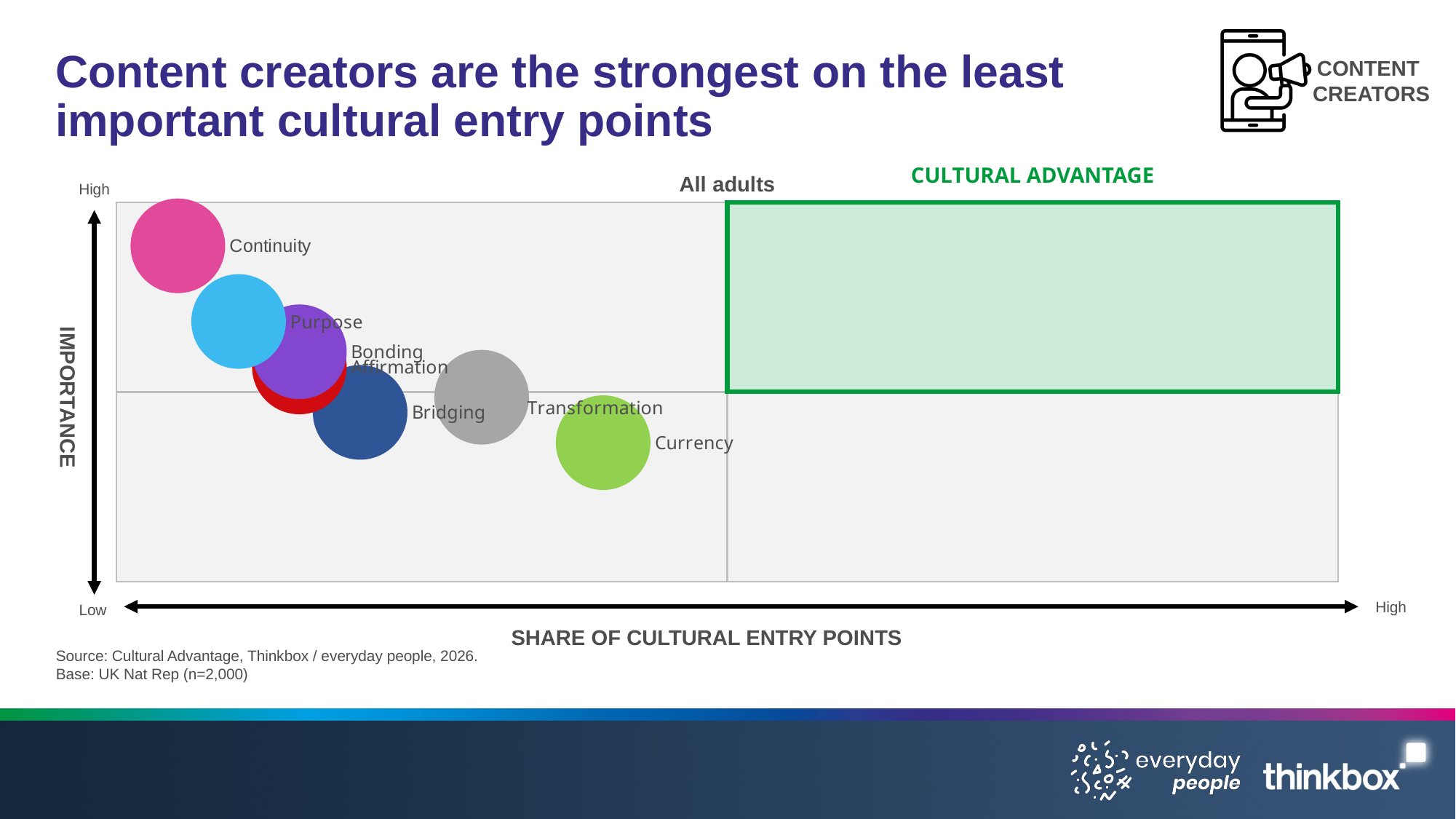
Which cultural entry point has the highest importance on the chart? Continuity Which cultural entry point has the highest share of cultural entry points for content creators? Currency Which cultural entry point has the lowest importance on the chart? Currency What is the label of the horizontal axis of the chart? Share of cultural entry points What kind of chart is shown on the slide? Bubble chart How many cultural entry points are plotted as bubbles on the chart? 7 Which has a higher importance, Continuity or Currency? Continuity What is the label of the vertical axis of the chart? Importance Which has a higher share of cultural entry points, Transformation or Bridging? Transformation How many bubbles fall inside the green 'Cultural Advantage' quadrant? 0 As the share of cultural entry points increases along the x axis, does importance rise or fall? Fall Which cultural entry point has the lowest share of cultural entry points for content creators? Continuity